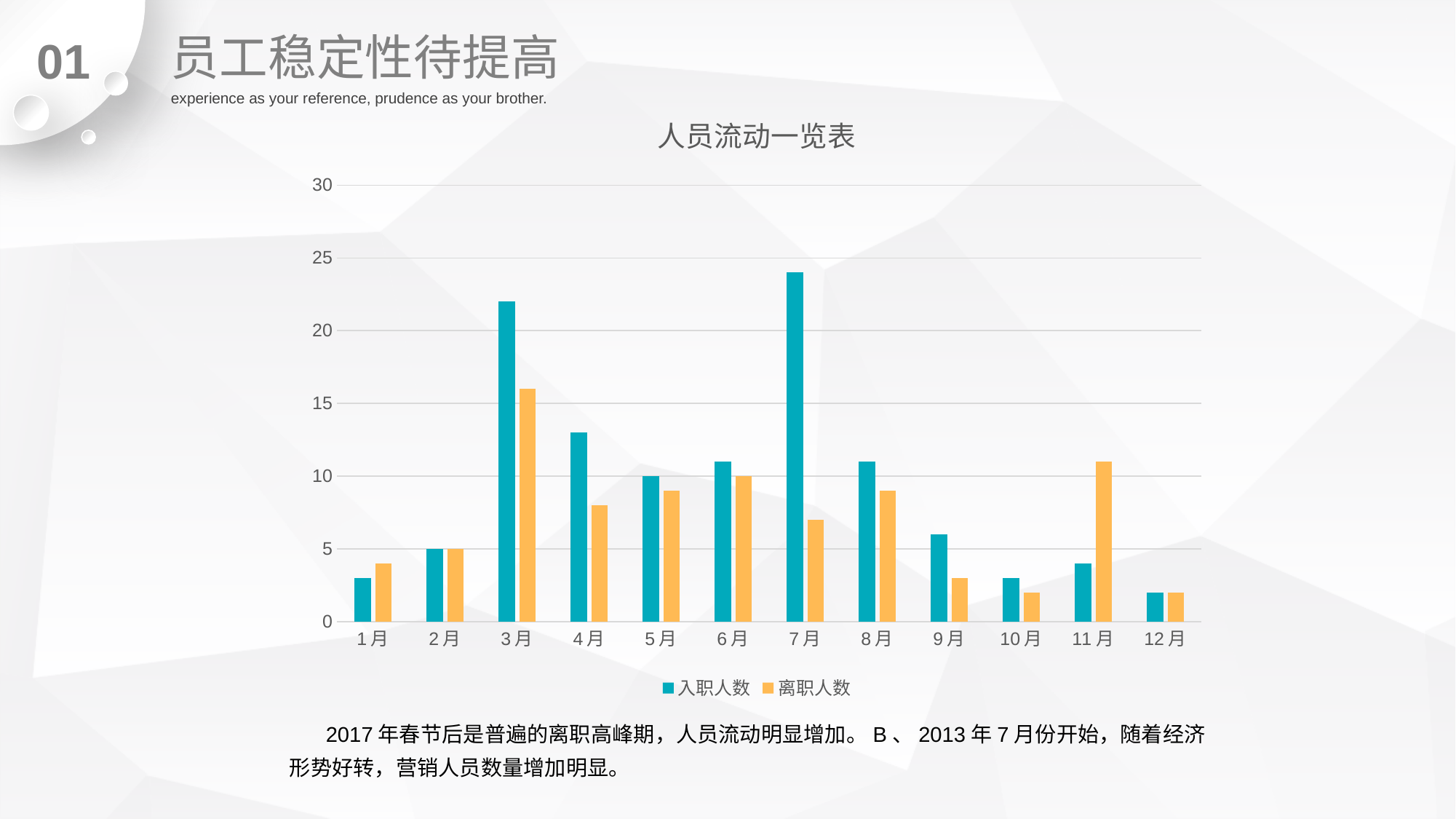
Which month has the highest 入职人数? 7月 Is the value of 入职人数 for 3月 greater or less than 20? greater What is the value of 入职人数 for 2月? 5 In 4月, which is larger, 入职人数 or 离职人数? 入职人数 Which month has the highest 离职人数? 3月 How many months are shown on the x axis? 12 What is the title of the chart? 人员流动一览表 How many series does the legend list? 2 What is the value of 离职人数 for 6月? 10 What kind of chart is shown on the slide? bar chart What is the value of 入职人数 for 5月? 10 Is the value of 离职人数 for 11月 greater or less than 10? greater